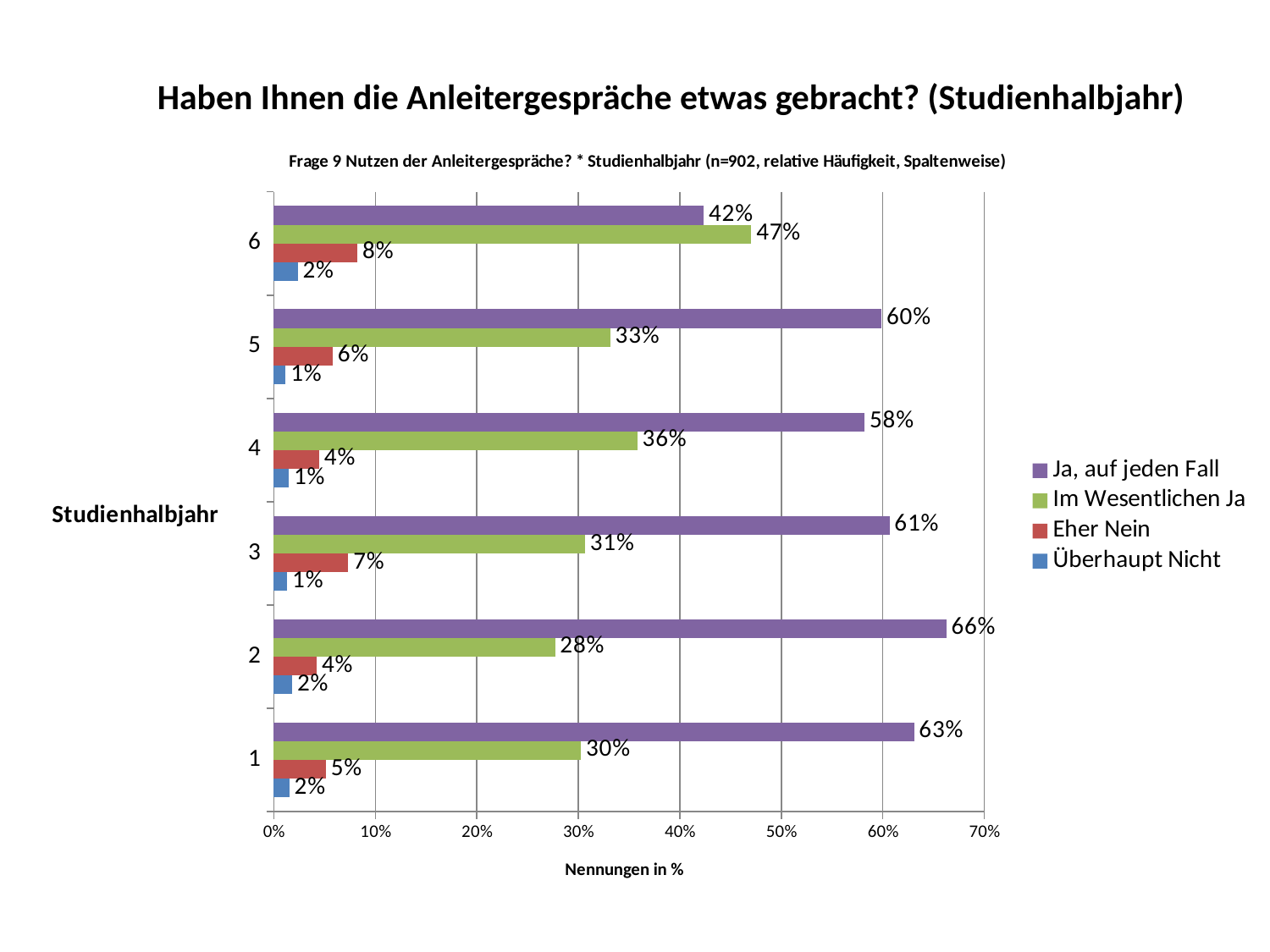
In Studienhalbjahr 6, which is larger: "Ja, auf jeden Fall" or "Im Wesentlichen Ja"? Im Wesentlichen Ja What is the value for "Eher Nein" in Studienhalbjahr 3? 7% How many series does the legend list? 4 How many Studienhalbjahr categories are shown on the y axis? 6 What is the label of the x axis? Nennungen in % What is the value for "Ja, auf jeden Fall" in Studienhalbjahr 2? 66% What is the value for "Im Wesentlichen Ja" in Studienhalbjahr 6? 47% Which Studienhalbjahr has the highest value for "Ja, auf jeden Fall"? 2 Which Studienhalbjahr has the lowest value for "Ja, auf jeden Fall"? 6 What kind of chart is shown on the slide? Bar chart What is the difference between the "Ja, auf jeden Fall" values for Studienhalbjahr 2 and Studienhalbjahr 6? 24% What is the value for "Überhaupt Nicht" in Studienhalbjahr 5? 1%